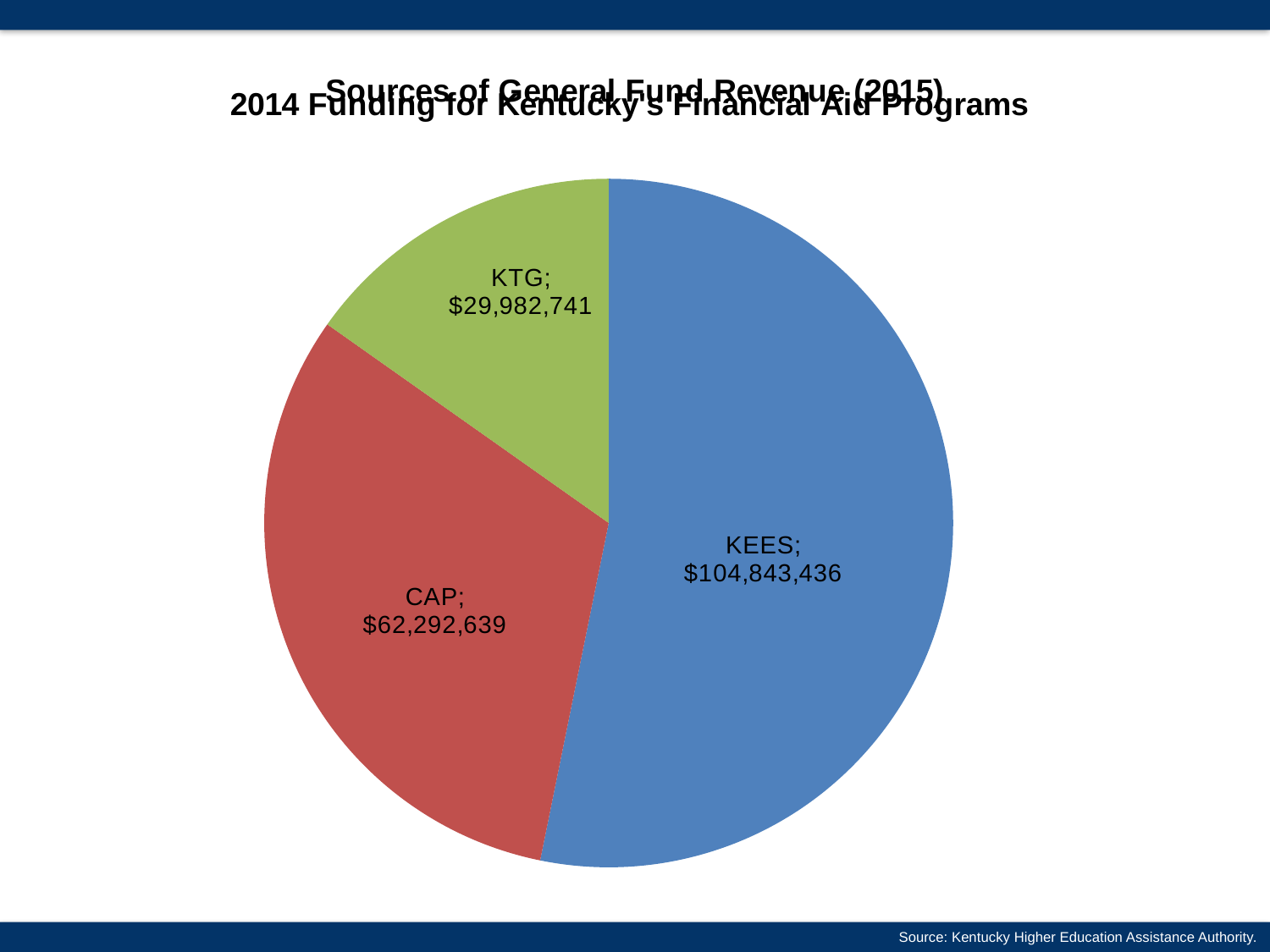
Which receives more funding, CAP or KTG? CAP What colour is the KEES slice? Blue What is the funding amount for KTG? $29,982,741 What is the funding amount for KEES? $104,843,436 How many slices does the pie chart have? 3 Which program receives the smallest amount of funding? KTG What is the funding amount for CAP? $62,292,639 What kind of chart is shown on the slide? Pie chart What is the total funding across all three programs? $197,118,816 Which program receives the largest amount of funding? KEES How much more funding does KEES receive than CAP? $42,550,797